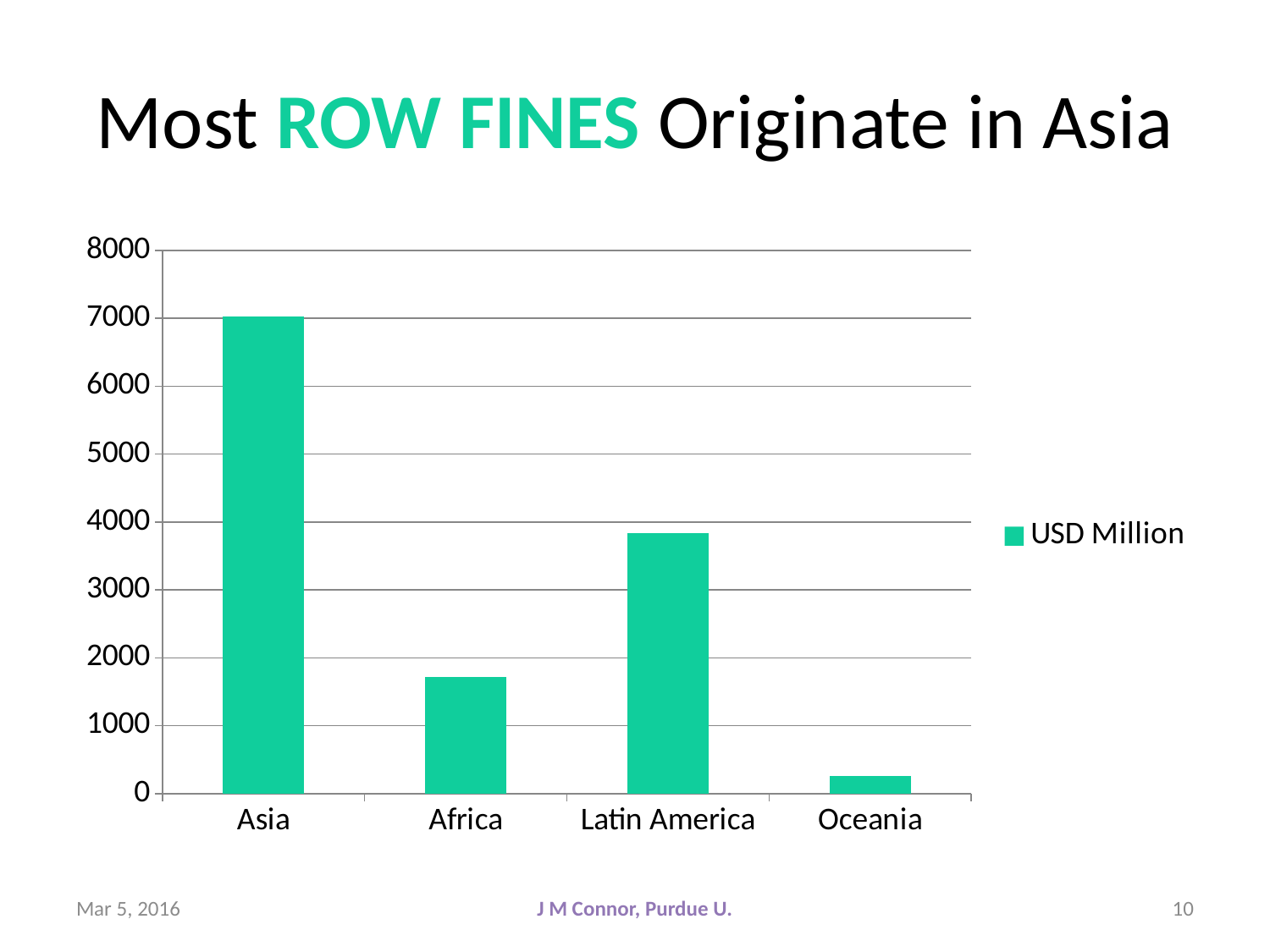
Is the value for Asia greater or less than 6000? greater Which category has the highest value in the chart? Asia Which has the larger value, Africa or Oceania? Africa Which has the larger value, Latin America or Africa? Latin America Is the value for Latin America greater or less than 3000? greater Is the value for Oceania greater or less than 1000? less How many series does the chart's legend list? 1 How many categories are shown on the x axis of the chart? 4 What kind of chart is shown on the slide? bar chart What series name is shown in the chart's legend? USD Million Which category has the lowest value in the chart? Oceania